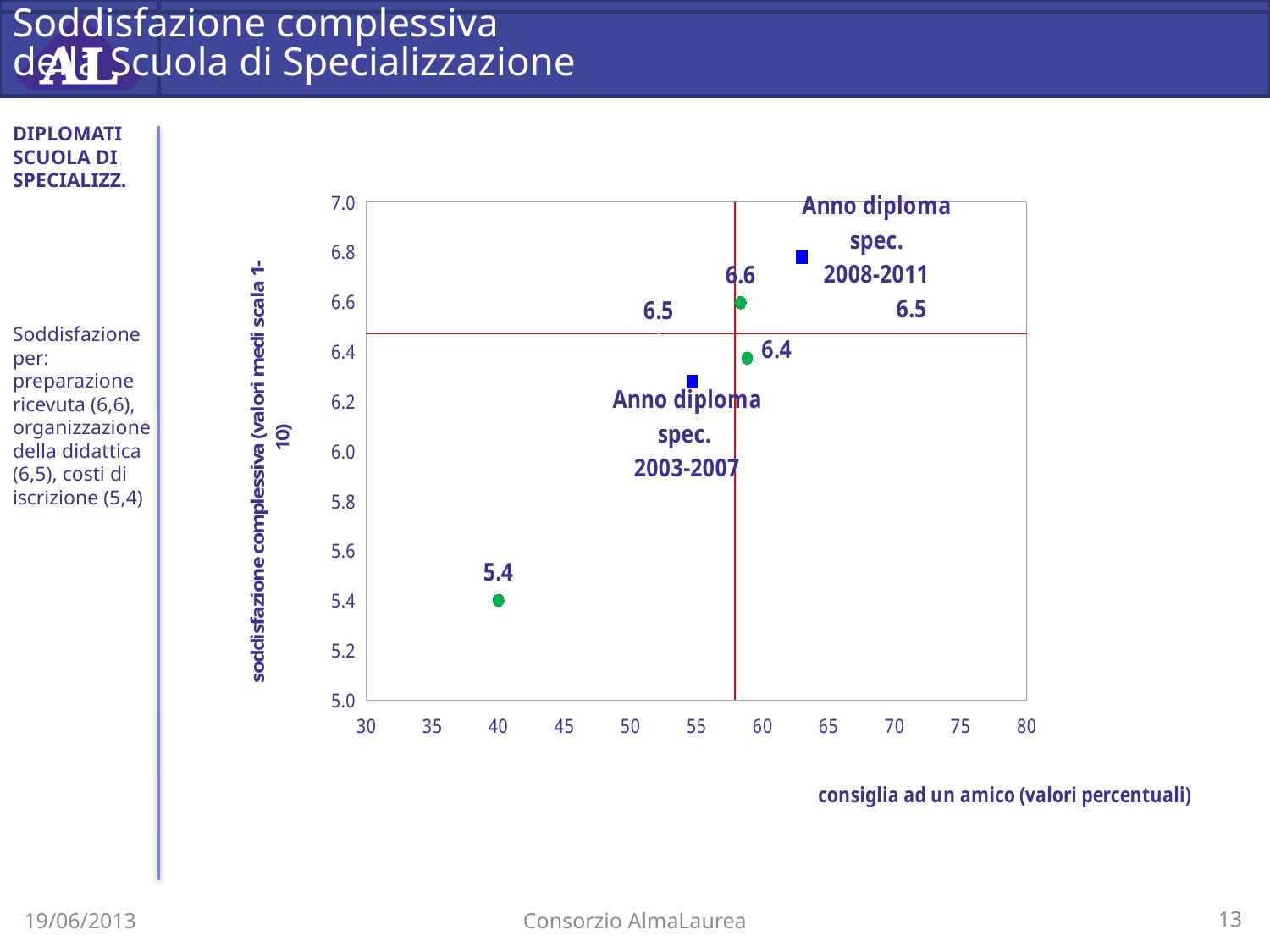
Is the vertical-axis value of the point labeled 'Anno diploma spec. 2008-2011' greater or less than 6.6? greater What is the difference between the highest green point label (6.6) and the lowest green point label (5.4)? 1.2 What is the title of the horizontal axis of the chart? consiglia ad un amico (valori percentuali) What kind of chart is shown on the slide? scatter chart Is the vertical-axis value of the point labeled 'Anno diploma spec. 2003-2007' greater or less than 6.4? less How many blue square points are plotted on the chart? 2 What is the title of the vertical axis of the chart? soddisfazione complessiva (valori medi scala 1-10) Is the horizontal-axis value of the point labeled 'Anno diploma spec. 2008-2011' greater or less than 60? greater What is the highest data label shown among the green points? 6.6 Which point has the higher overall satisfaction: 'Anno diploma spec. 2008-2011' or 'Anno diploma spec. 2003-2007'? Anno diploma spec. 2008-2011 What is the lowest data label shown among the green points? 5.4